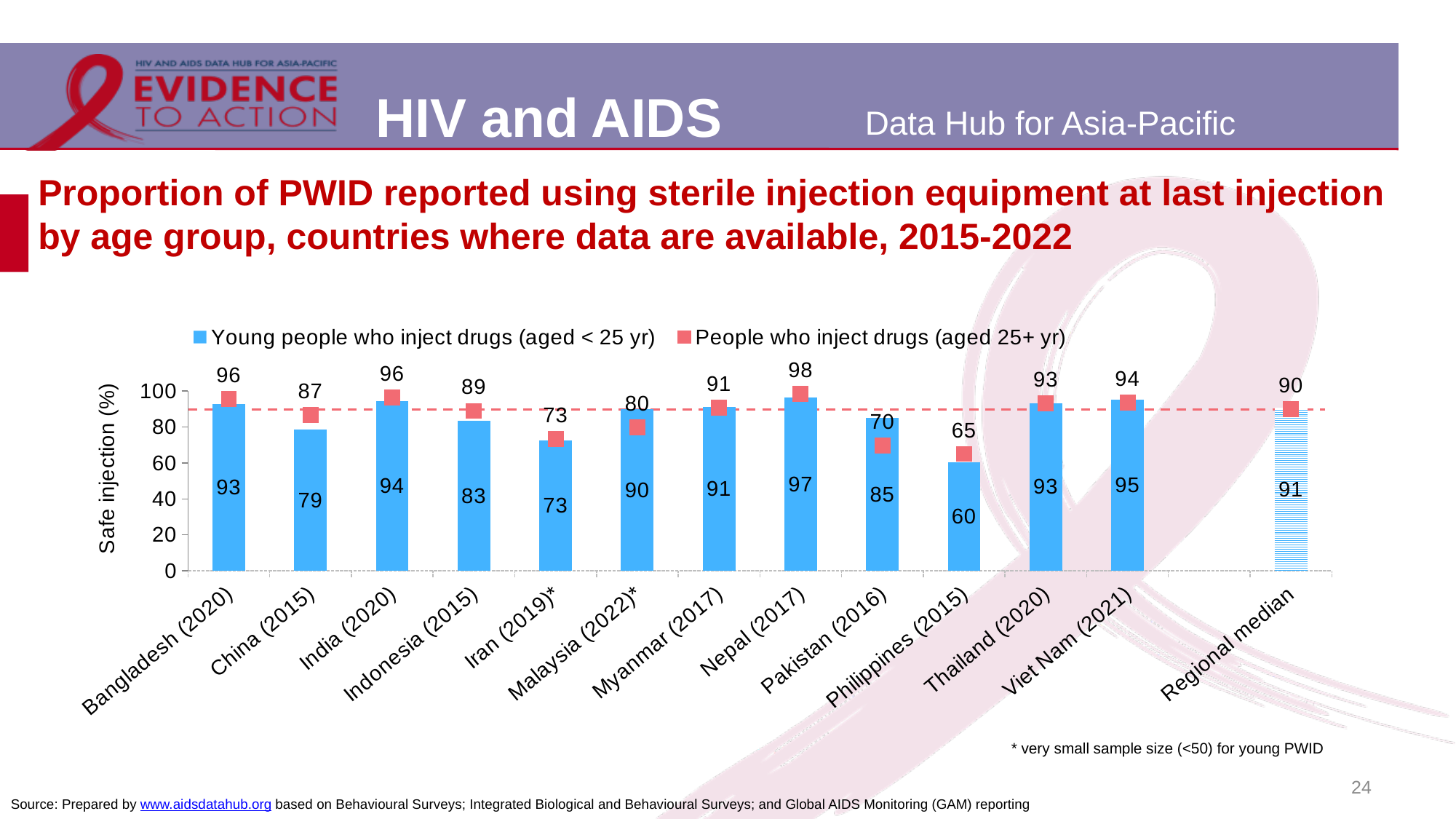
Is the value for young people who inject drugs (aged < 25 yr) in Iran (2019)* greater or less than 80? less Which country has the highest value for people who inject drugs (aged 25+ yr)? Nepal (2017) What is the label of the y axis? Safe injection (%) What kind of chart is used to show the values for young people who inject drugs (aged < 25 yr)? Bar chart How many categories are shown on the x axis, including the regional median? 13 What is the value for young people who inject drugs (aged < 25 yr) in Nepal (2017)? 97 Which country has the lowest value for young people who inject drugs (aged < 25 yr)? Philippines (2015) How many series does the legend list? 2 What is the regional median for young people who inject drugs (aged < 25 yr)? 91 In Malaysia (2022)*, which is larger: the value for young people who inject drugs (aged < 25 yr) or the value for people who inject drugs (aged 25+ yr)? Young people who inject drugs (aged < 25 yr) What is the value for people who inject drugs (aged 25+ yr) in China (2015)? 87 What is the difference between the young people (aged < 25 yr) value and the aged 25+ yr value for Pakistan (2016)? 15